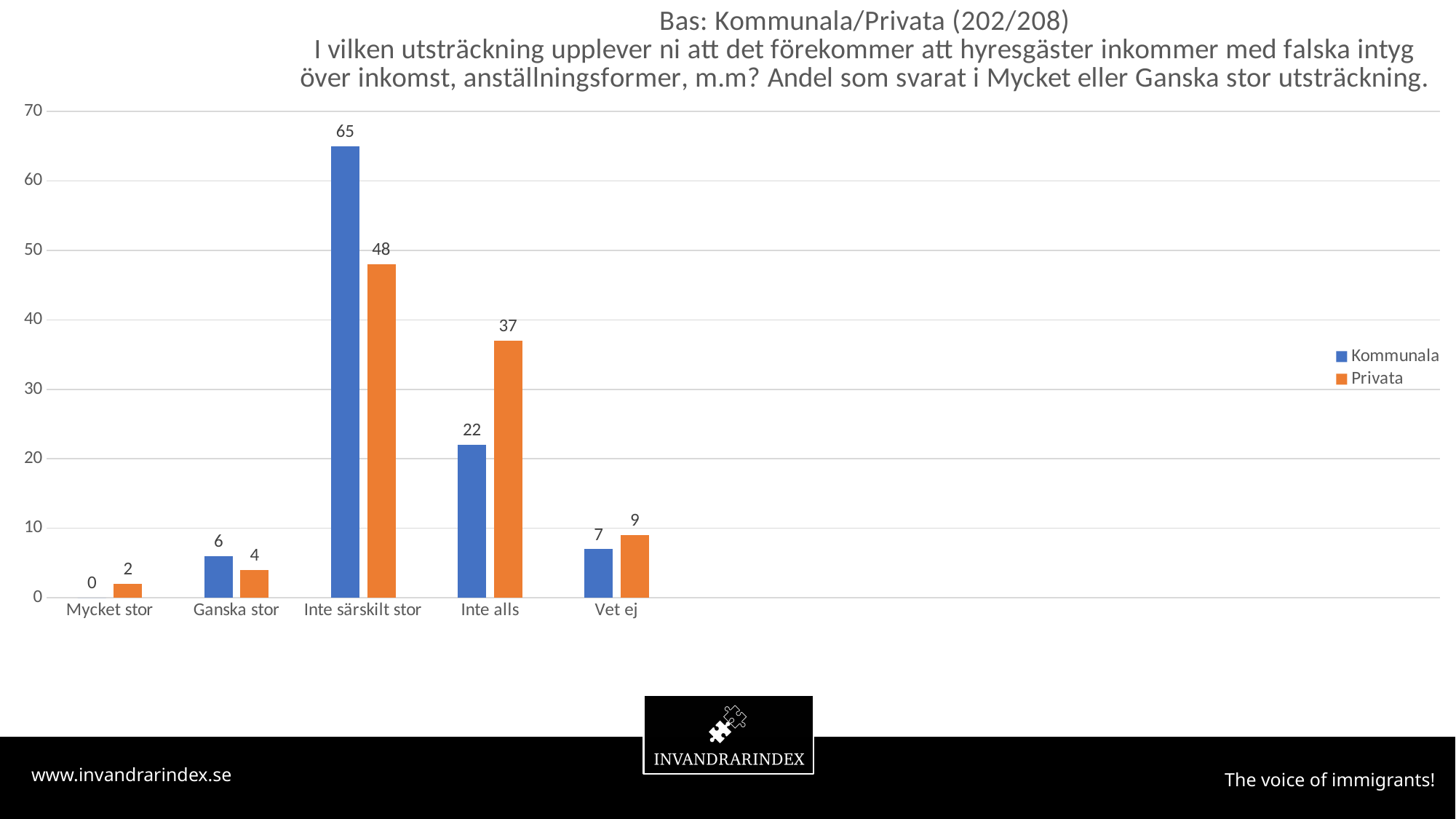
Which category has the lowest Kommunala value? Mycket stor What kind of chart is shown on the slide? Bar chart Which is larger for Ganska stor, the Kommunala value or the Privata value? Kommunala What is the Kommunala value for Inte särskilt stor? 65 What is the difference between the Privata and Kommunala values for Inte alls? 15 What is the Privata value for Vet ej? 9 How many categories are shown on the x axis? 5 What is the difference between the Kommunala and Privata values for Inte särskilt stor? 17 What is the Kommunala value for Mycket stor? 0 Which category has the highest Privata value? Inte särskilt stor How many series does the legend list? 2 What is the Privata value for Inte alls? 37